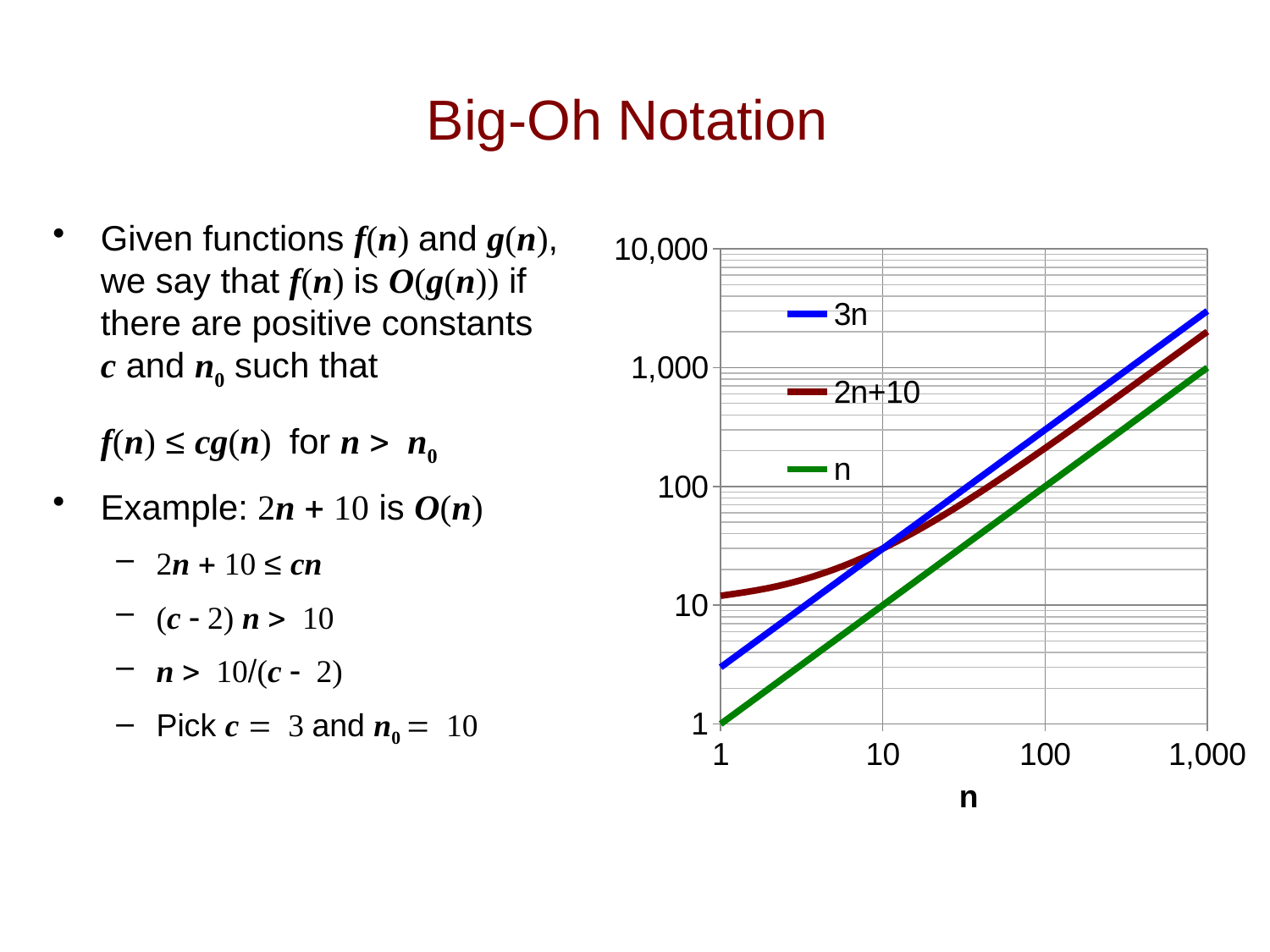
What is the label on the chart's x axis? n What is the value of the n series at n = 10? 10 Do the values of the n series rise or fall as n increases? rise Is the value of the 3n series at n = 1 greater or less than 10? less What is the value of the n series at n = 1,000? 1,000 At n = 1,000, which series has the highest value? 3n What kind of chart is shown on the slide? line chart How many series does the chart's legend list? 3 Do the values of the 3n series rise or fall as n increases? rise Is the value of the 3n series at n = 1,000 greater or less than 1,000? greater What are the three series named in the chart's legend? 3n, 2n+10, n At n = 1, which series has the higher value, 3n or 2n+10? 2n+10